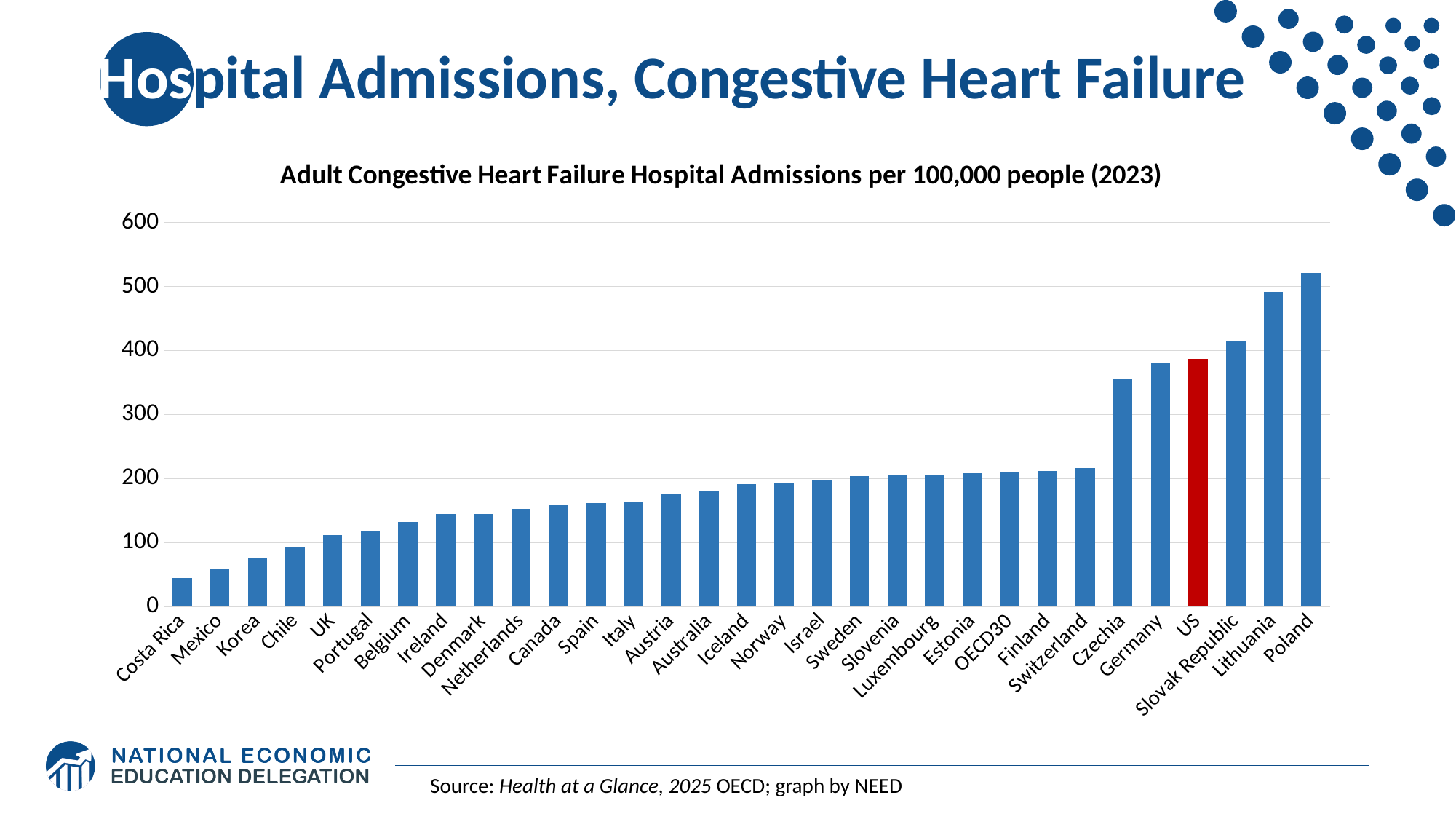
Is the value for the US greater or less than 400? less Which country has the highest rate of adult congestive heart failure hospital admissions per 100,000 people? Poland Is the value for Czechia greater or less than 300? greater Which bar is coloured red instead of blue? US Do the values rise or fall moving from left to right along the x axis? rise What kind of chart is shown on the slide? bar chart Is the value for Poland greater or less than 500? greater Which country has the lowest rate of adult congestive heart failure hospital admissions per 100,000 people? Costa Rica How many bars (countries and groups) are plotted in the chart? 31 Which has a higher value, the US or the Slovak Republic? Slovak Republic